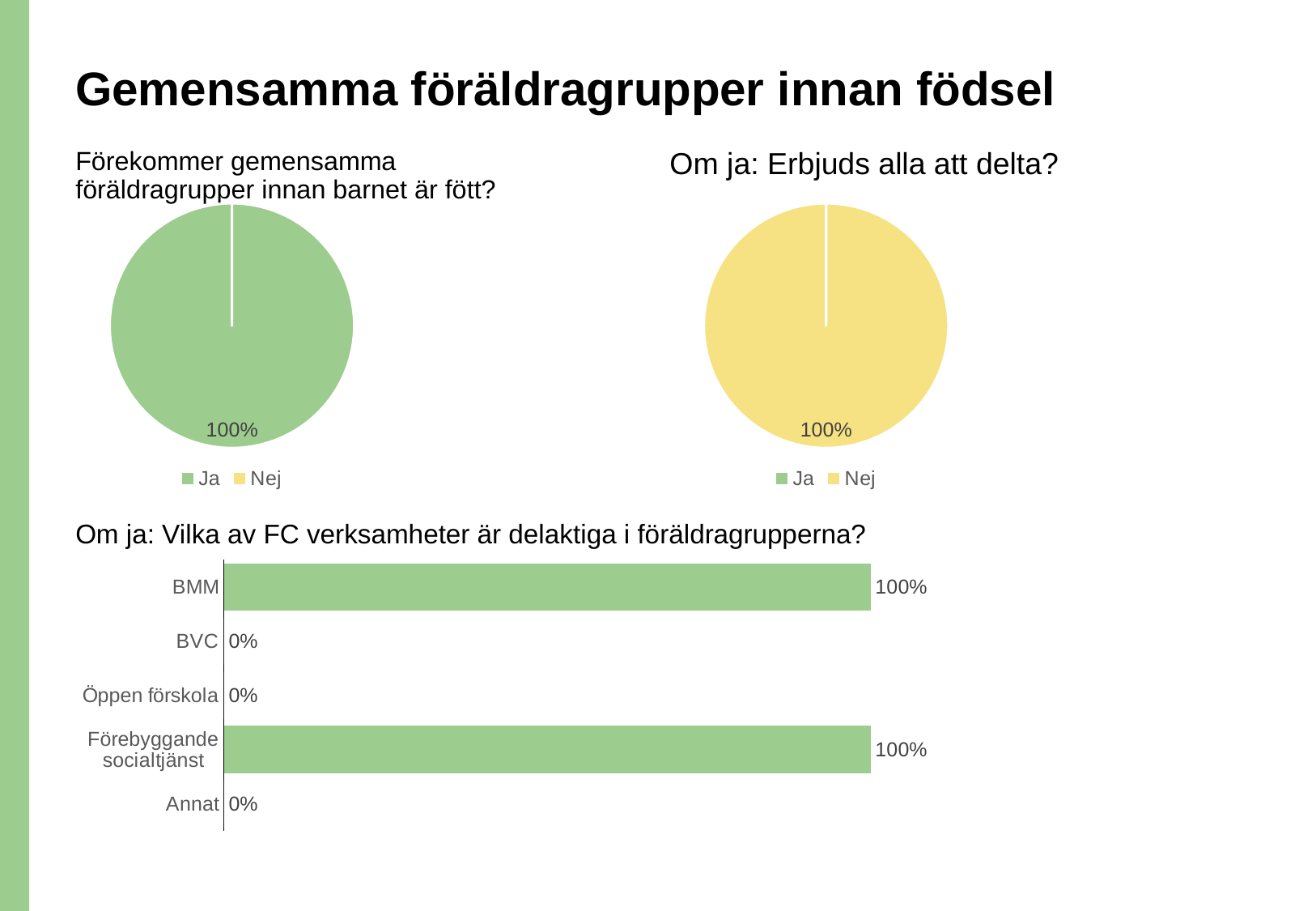
What kind of chart is the chart titled "Om ja: Erbjuds alla att delta?"? pie chart What kind of chart is the chart titled "Om ja: Vilka av FC verksamheter är delaktiga i föräldragrupperna?"? bar chart In the bar chart titled "Om ja: Vilka av FC verksamheter är delaktiga i föräldragrupperna?", which is larger, BMM or Öppen förskola? BMM In the pie chart titled "Om ja: Erbjuds alla att delta?", which category makes up the whole pie? Nej In the pie chart titled "Förekommer gemensamma föräldragrupper innan barnet är fött?", how many entries does the legend list? 2 In the bar chart titled "Om ja: Vilka av FC verksamheter är delaktiga i föräldragrupperna?", what is the value for Förebyggande socialtjänst? 100% In the bar chart titled "Om ja: Vilka av FC verksamheter är delaktiga i föräldragrupperna?", how many categories are shown? 5 In the bar chart titled "Om ja: Vilka av FC verksamheter är delaktiga i föräldragrupperna?", what is the value for BVC? 0% In the bar chart titled "Om ja: Vilka av FC verksamheter är delaktiga i föräldragrupperna?", what is the value for BMM? 100% In the bar chart titled "Om ja: Vilka av FC verksamheter är delaktiga i föräldragrupperna?", what is the difference between BMM and Annat? 100% In the pie chart titled "Förekommer gemensamma föräldragrupper innan barnet är fött?", what share does the Ja slice have? 100% In the pie chart titled "Om ja: Erbjuds alla att delta?", what share does the Nej slice have? 100%